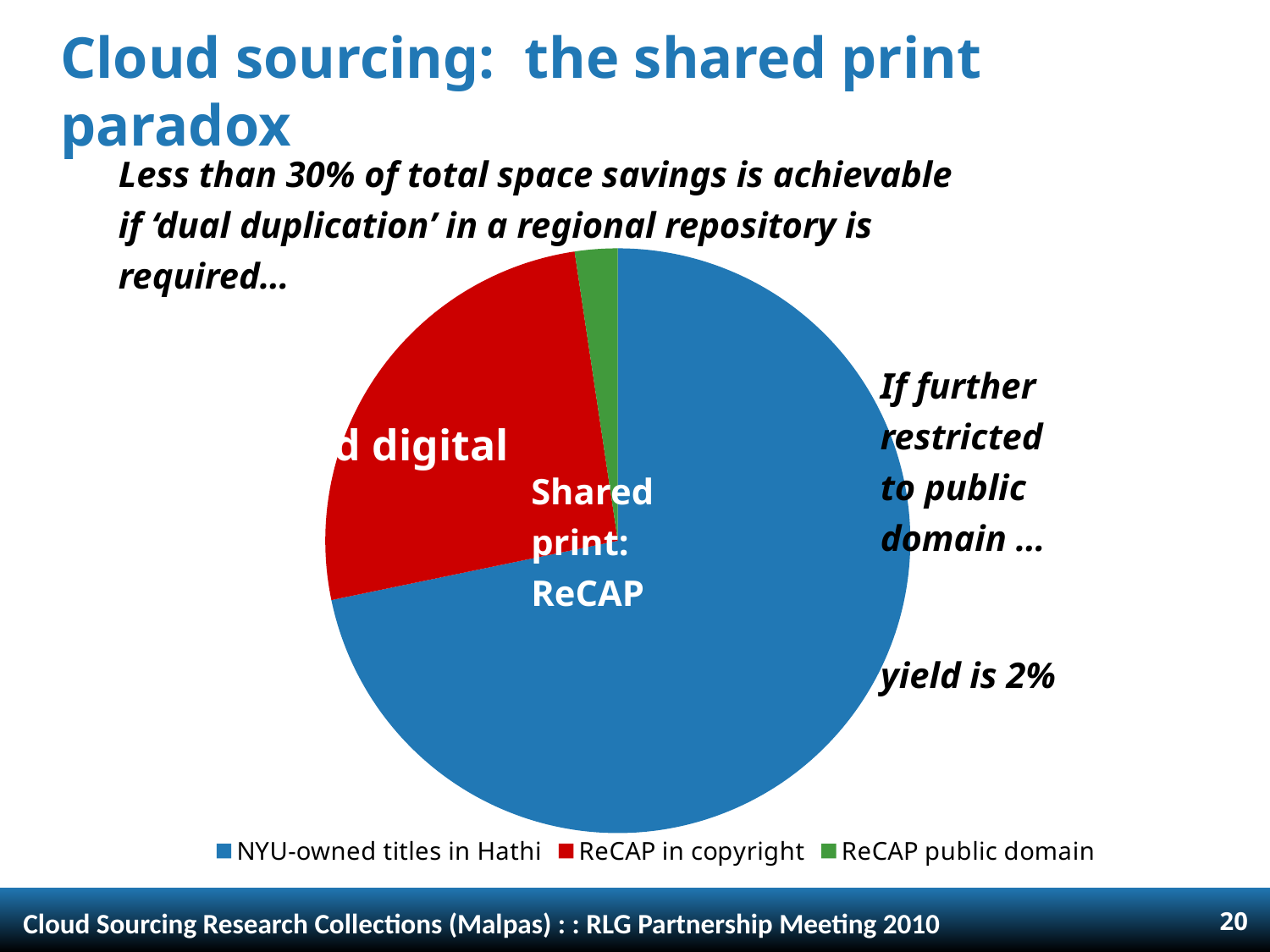
What colour is the slice for NYU-owned titles in Hathi? blue Which category has the smallest slice of the pie chart? ReCAP public domain What colour is the slice for ReCAP in copyright? red Which slice is larger: NYU-owned titles in Hathi or ReCAP in copyright? NYU-owned titles in Hathi Which slice is larger: ReCAP in copyright or ReCAP public domain? ReCAP in copyright How many slices does the pie chart have? 3 What kind of chart is shown on the slide? pie chart Which category has the largest slice of the pie chart? NYU-owned titles in Hathi How many entries does the legend of the pie chart list? 3